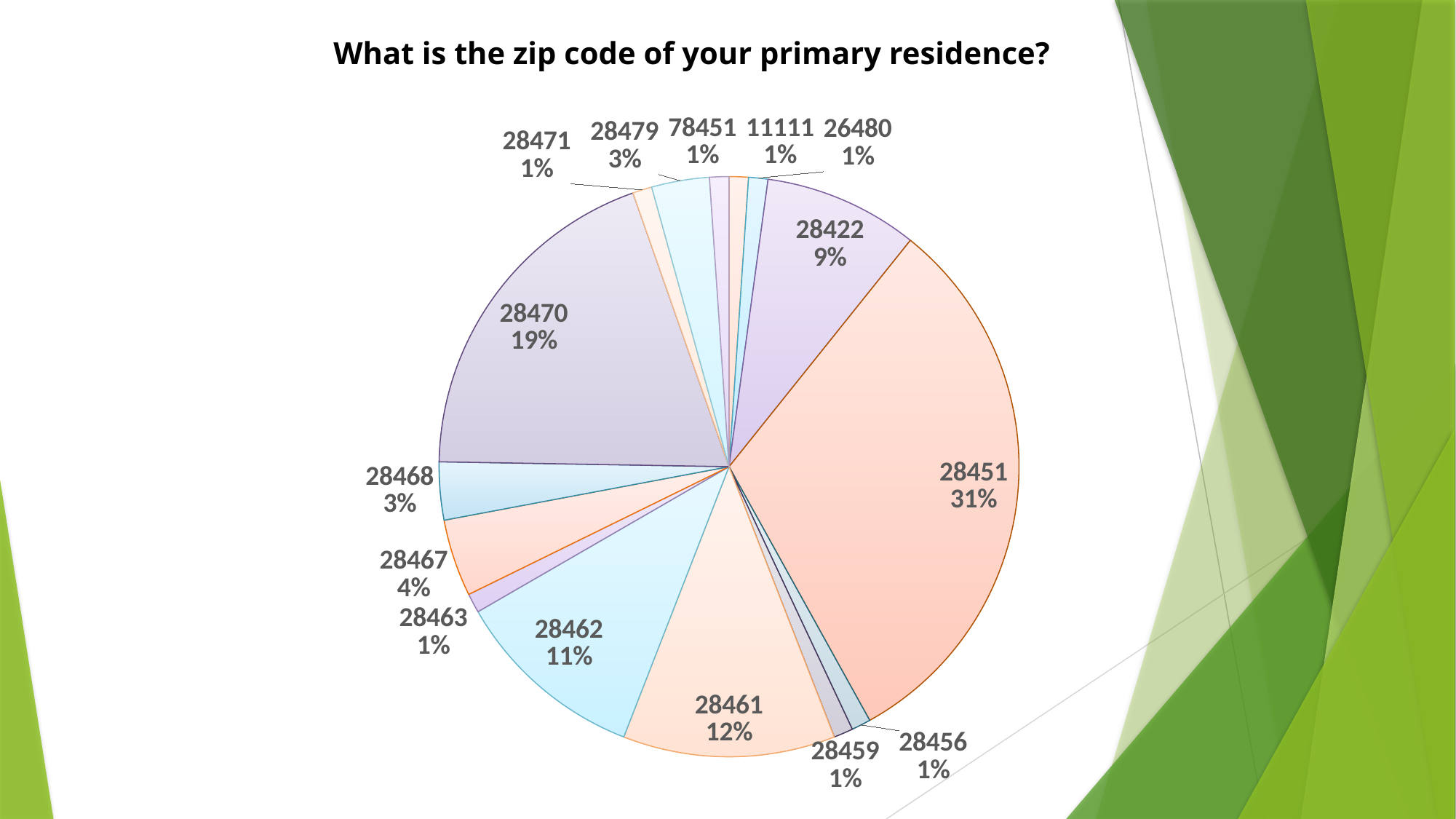
What is the difference in percentage points between zip code 28461 and zip code 28462? 1 What type of chart is shown on the slide? pie chart What percentage is shown for zip code 28461? 12% What percentage is shown for zip code 28422? 9% What percentage is shown for zip code 28467? 4% What percentage is shown for zip code 28470? 19% What is the difference in percentage points between zip code 28451 and zip code 28470? 12 What share of the pie does zip code 28451 represent? 31% Which has a larger share, zip code 28479 or zip code 28467? 28467 Which zip code has the largest share of the pie? 28451 What is the title of the chart? What is the zip code of your primary residence? Which has a larger share, zip code 28470 or zip code 28422? 28470